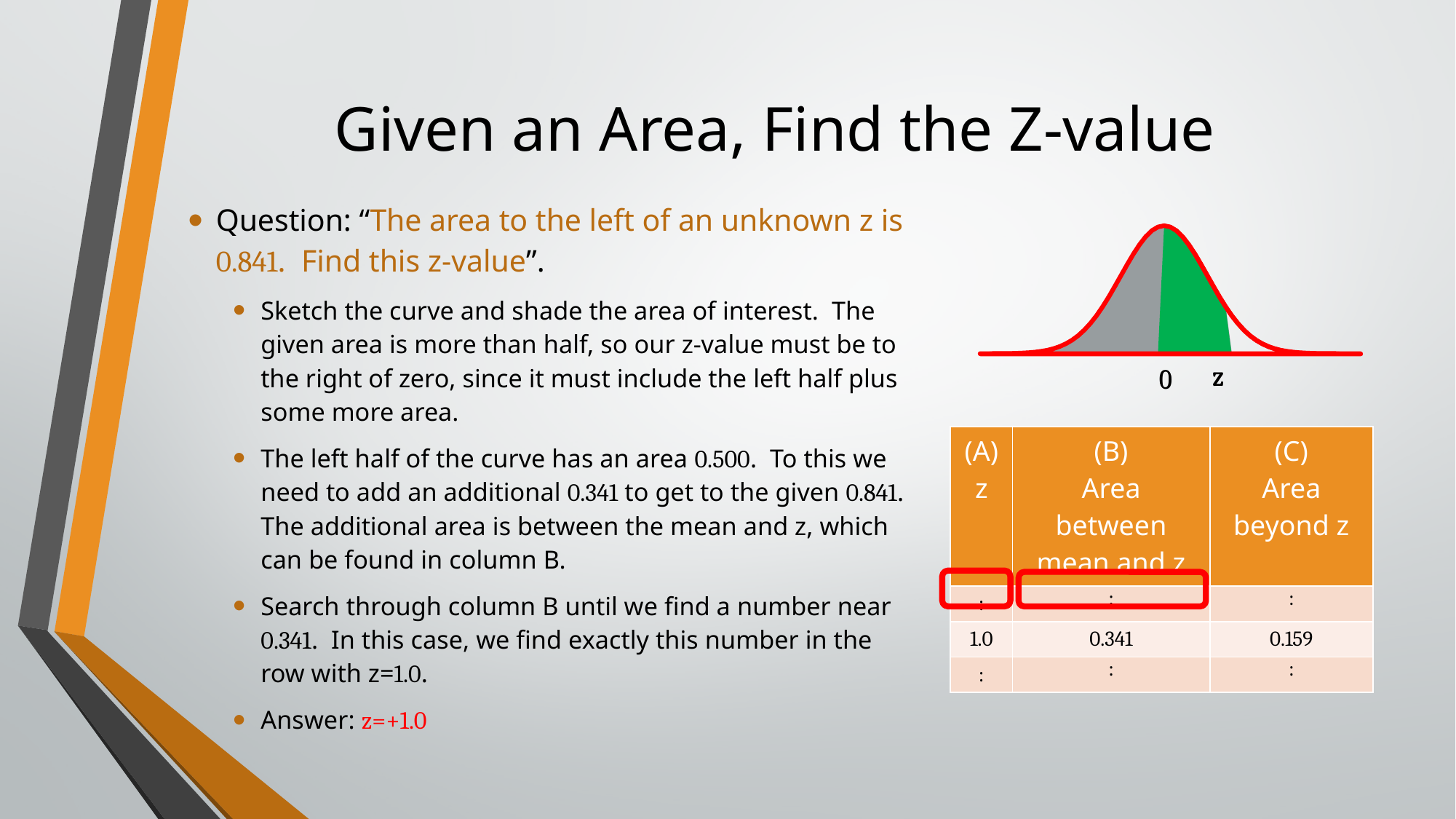
In the table below the curve, what is the difference between the area between mean and z and the area beyond z for z = 1.0? 0.182 In the bell curve diagram, what colour is the shaded region between 0 and z? Green In the table below the curve, which is larger for z = 1.0: the area between mean and z or the area beyond z? Area between mean and z What kind of chart is shown at the top right of the slide? A normal distribution (bell) curve How many columns does the table below the curve have? 3 What two labels appear beneath the bell curve on its horizontal axis? 0 and z In the table below the curve, what is the value in column (B), Area between mean and z, for z = 1.0? 0.341 In the table below the curve, what is the value in column (C), Area beyond z, for z = 1.0? 0.159